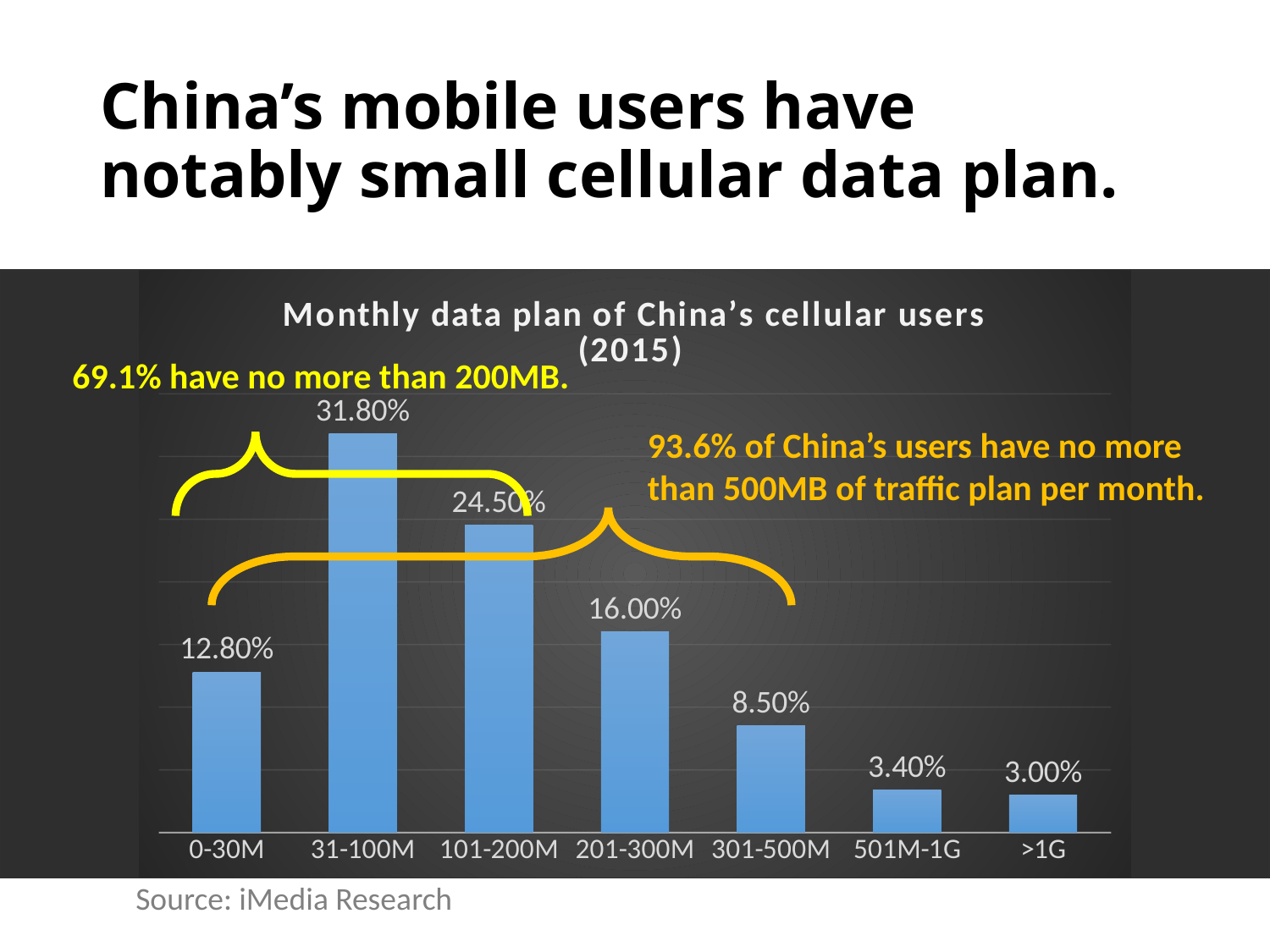
Which category has the highest value? 31-100M What is the title of the chart? Monthly data plan of China's cellular users (2015) How many categories are shown on the x axis? 7 What is the difference between the values for 0-30M and 201-300M? 3.20% What is the value for the >1G category? 3.00% Which category has the lowest value? >1G What is the value for the 301-500M category? 8.50% Which is larger, the value for 0-30M or the value for 301-500M? 0-30M Do the values rise or fall along the x axis from 31-100M to >1G? Fall What kind of chart is shown on the slide? Bar chart What is the difference between the values for 31-100M and 101-200M? 7.30% What is the value for the 31-100M category? 31.80%